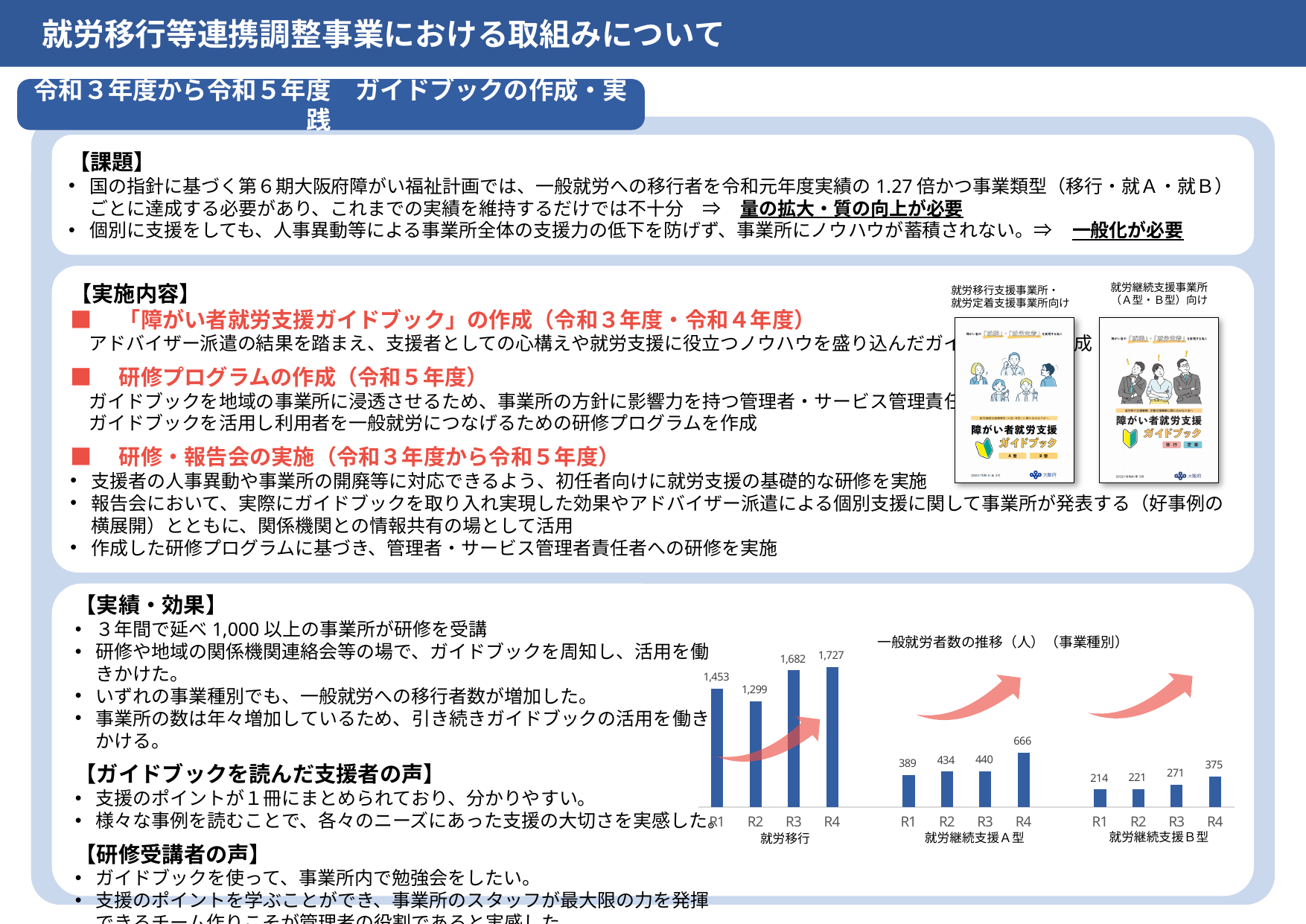
What is the title of the chart? 一般就労者数の推移（人）（事業種別） What is the difference between the R4 and R1 values in the 就労継続支援Ｂ型 group? 161 What is the value for R1 in the 就労継続支援Ａ型 group? 389 Which year has the lowest value in the 就労移行 group? R2 How many bars are plotted in the chart in total? 12 Do the values in the 就労継続支援Ｂ型 group rise or fall from R1 to R4? Rise What is the value for R3 in the 就労継続支援Ｂ型 group? 271 Which year has the highest value in the 就労移行 group? R4 What is the difference between the R4 and R3 values in the 就労継続支援Ａ型 group? 226 What is the value for R4 in the 就労移行 group of the chart? 1,727 Which is larger: the R2 value for 就労継続支援Ａ型 or the R4 value for 就労継続支援Ｂ型? R2 value for 就労継続支援Ａ型 What kind of chart is shown on the slide? Bar chart